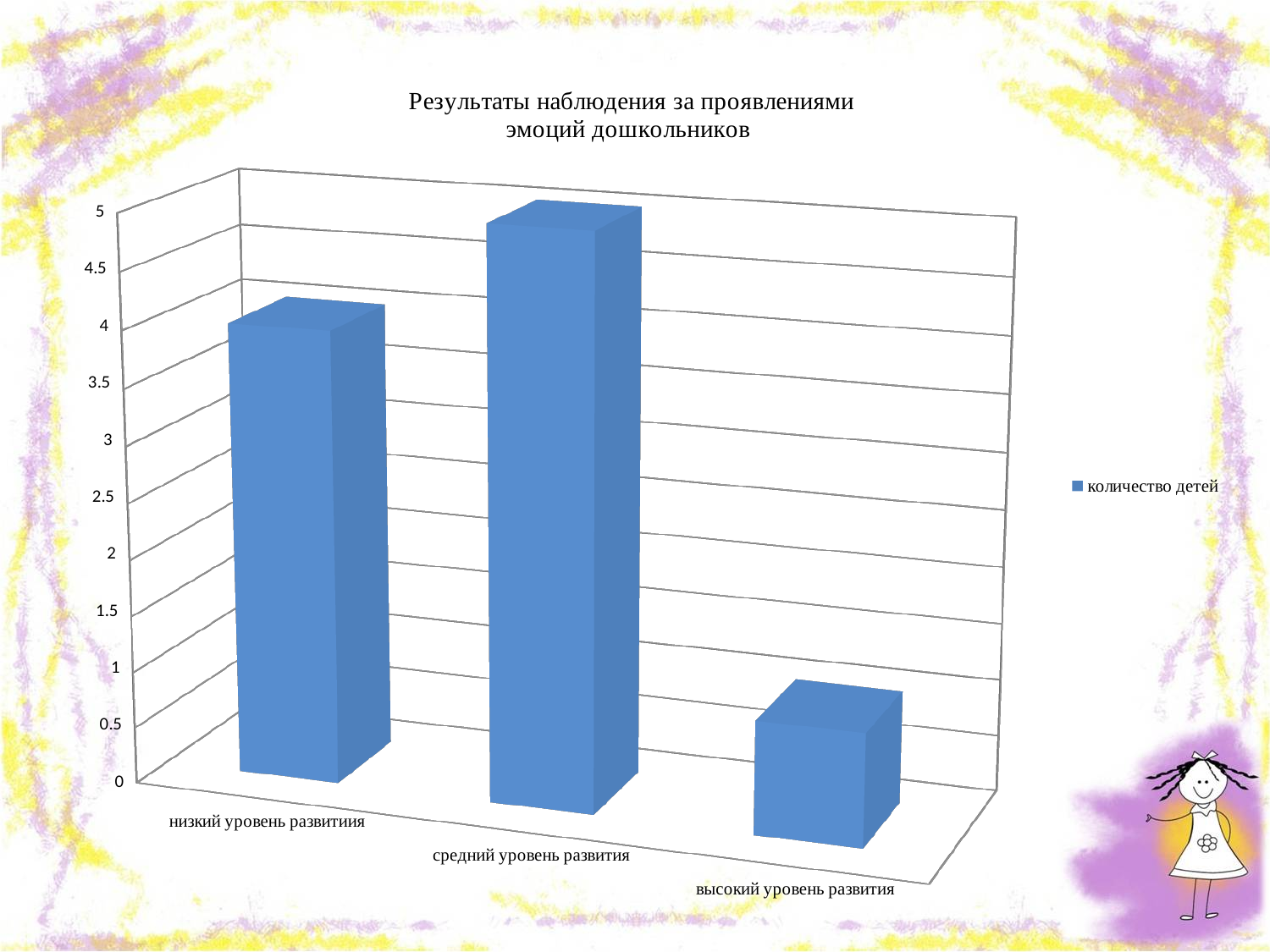
Is the value for высокий уровень развития greater or less than 2? less How many categories are shown on the x axis of the chart? 3 Is the value for низкий уровень развитиия greater or less than 3? greater What is the name of the series shown in the legend? количество детей Which category has the lowest value? высокий уровень развития How many series does the legend list? 1 Which is larger, the value for низкий уровень развитиия or the value for высокий уровень развития? низкий уровень развитиия What kind of chart is shown on the slide? bar chart Which category has the highest value? средний уровень развития Is the value for средний уровень развития greater or less than 4? greater Which is larger, the value for средний уровень развития or the value for низкий уровень развитиия? средний уровень развития What is the title of the chart? Результаты наблюдения за проявлениями эмоций дошкольников